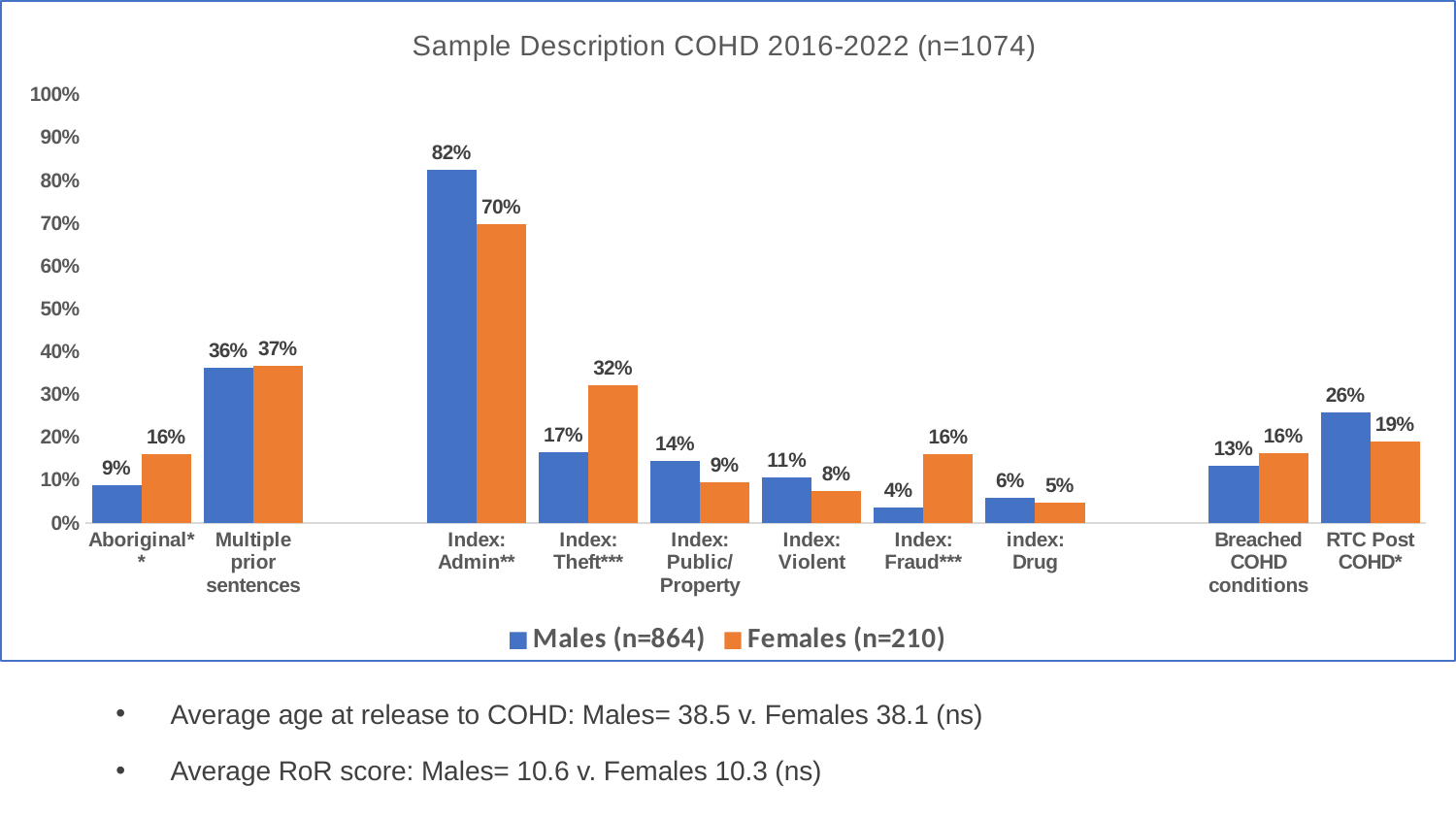
Which category has the highest value for Females? Index: Admin What is the difference between the Males and Females values for Index: Admin? 12% What is the value for Males for RTC Post COHD? 26% Which category has the lowest value for Males? Index: Fraud What is the value for Females for Index: Theft? 32% How many categories are shown on the x axis? 10 Which is larger for Index: Fraud, the Males value or the Females value? Females What is the title of the chart? Sample Description COHD 2016-2022 (n=1074) What is the value for Males for Index: Admin? 82% What is the value for Females for Aboriginal? 16% What kind of chart is shown on the slide? Bar chart How many series does the legend list? 2